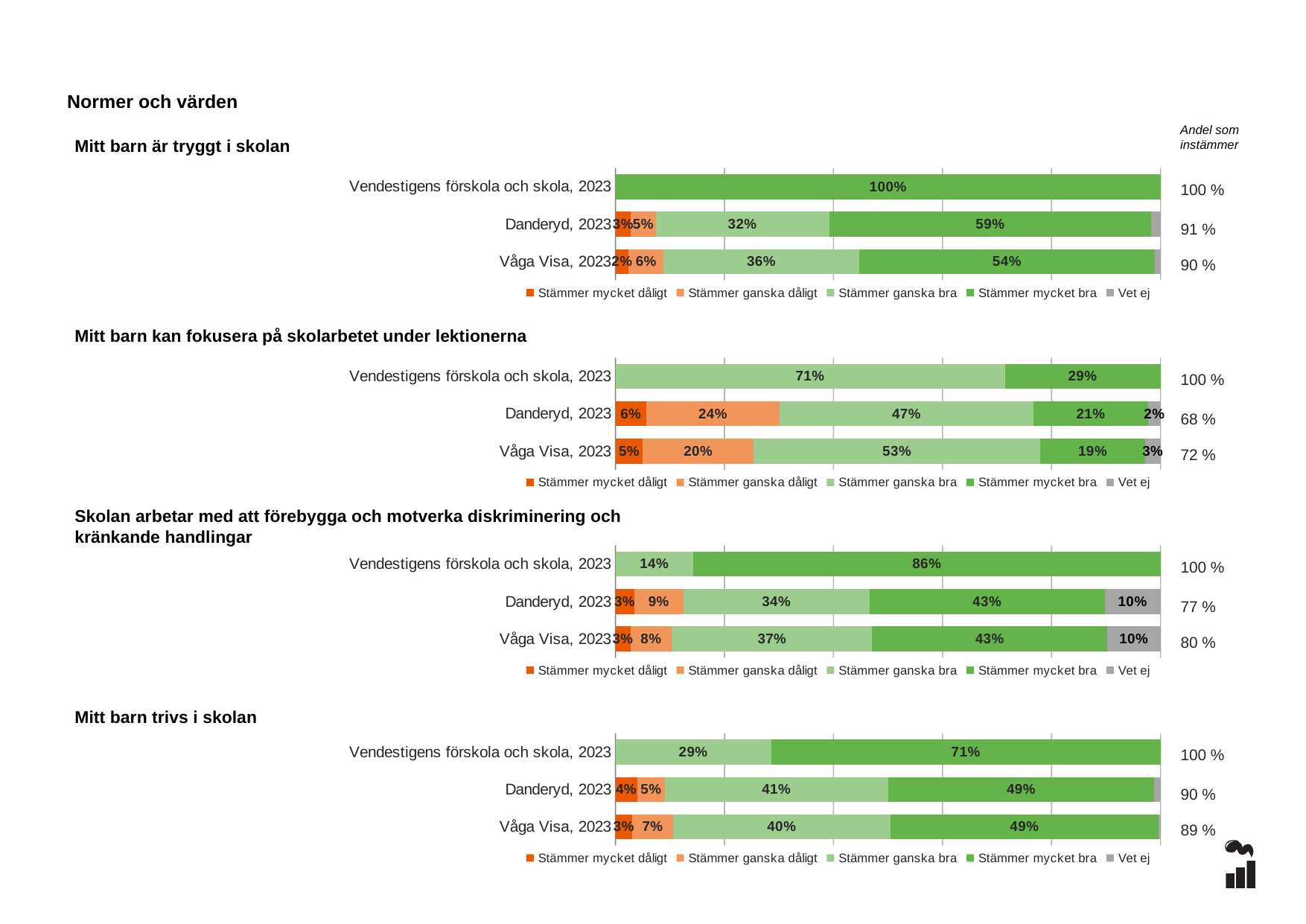
What kind of chart is 'Mitt barn kan fokusera på skolarbetet under lektionerna'? Stacked bar chart In the chart 'Skolan arbetar med att förebygga och motverka diskriminering och kränkande handlingar', what is the 'Vet ej' value for Danderyd, 2023? 10% In the chart 'Skolan arbetar med att förebygga och motverka diskriminering och kränkande handlingar', which category has the lowest 'Stämmer ganska bra' value? Vendestigens förskola och skola, 2023 In the chart 'Mitt barn kan fokusera på skolarbetet under lektionerna', which category has the highest 'Stämmer ganska dåligt' value? Danderyd, 2023 How many series does the legend list for the chart 'Mitt barn trivs i skolan'? 5 In the chart 'Mitt barn trivs i skolan', what is the 'Stämmer mycket bra' value for Vendestigens förskola och skola, 2023? 71% In the chart 'Skolan arbetar med att förebygga och motverka diskriminering och kränkande handlingar', what is the 'Andel som instämmer' value shown for Våga Visa, 2023? 80 % How many categories are shown in the chart 'Mitt barn är tryggt i skolan'? 3 In the chart 'Mitt barn trivs i skolan', which is larger: the 'Stämmer ganska bra' value for Danderyd, 2023 or for Våga Visa, 2023? Danderyd, 2023 In the chart 'Mitt barn är tryggt i skolan', what is the 'Stämmer mycket bra' value for Danderyd, 2023? 59% In the chart 'Mitt barn kan fokusera på skolarbetet under lektionerna', what is the difference between the 'Stämmer ganska bra' values for Vendestigens förskola och skola, 2023 and Danderyd, 2023? 24% In the chart 'Mitt barn kan fokusera på skolarbetet under lektionerna', what is the 'Stämmer ganska bra' value for Våga Visa, 2023? 53%